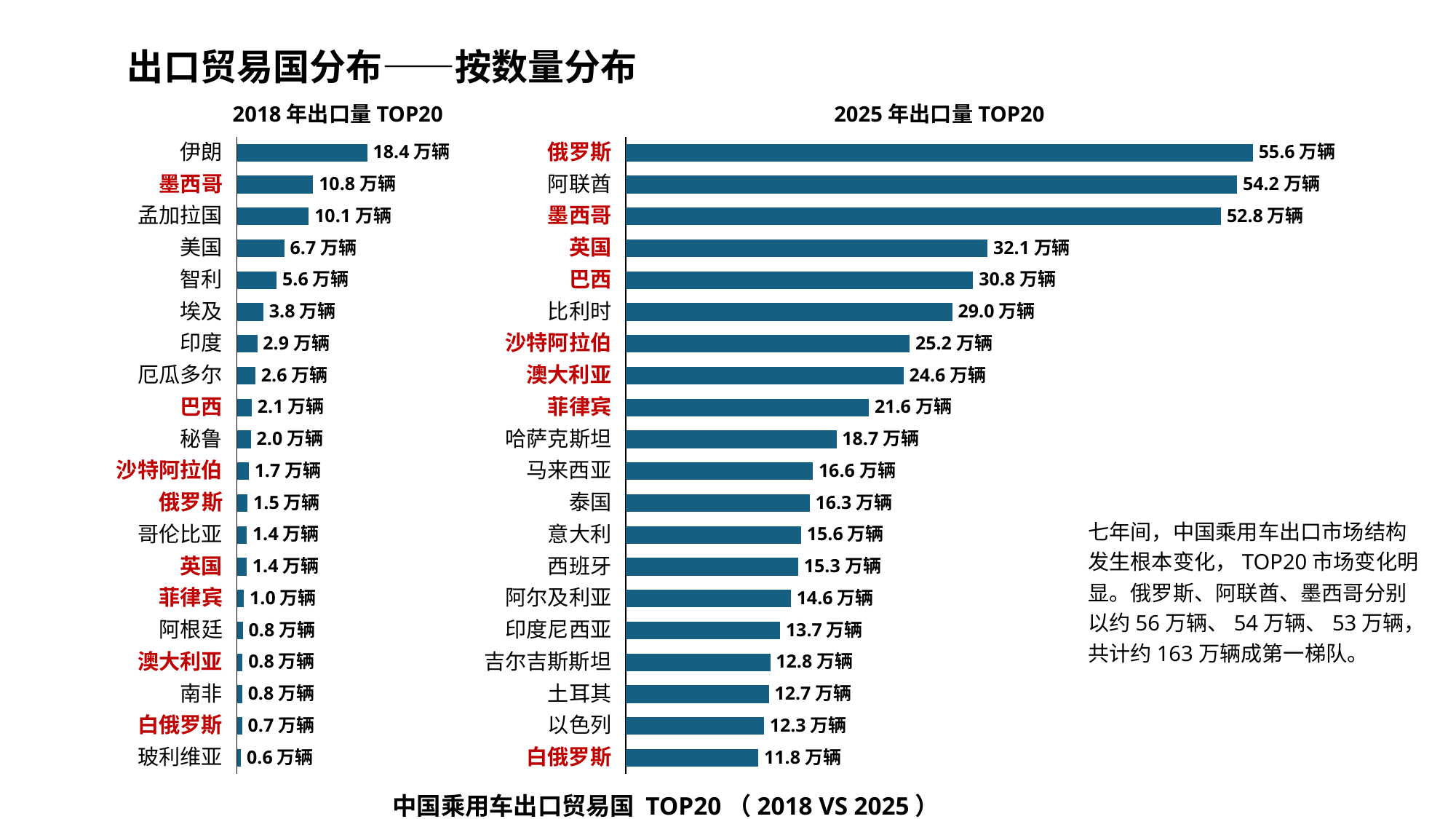
In the 2025 年出口量 TOP20 chart, what is the value for 阿联酋? 54.2 万辆 What kind of chart is the 2018 年出口量 TOP20 chart? Bar chart In the 2025 年出口量 TOP20 chart, what is the difference between 俄罗斯 and 墨西哥? 2.8 万辆 In the 2025 年出口量 TOP20 chart, which is larger, 英国 or 巴西? 英国 In the 2025 年出口量 TOP20 chart, what is the value for 白俄罗斯? 11.8 万辆 In the 2018 年出口量 TOP20 chart, which country has the lowest value? 玻利维亚 In the 2018 年出口量 TOP20 chart, which is larger, 美国 or 智利? 美国 In the 2018 年出口量 TOP20 chart, what is the value for 伊朗? 18.4 万辆 In the 2018 年出口量 TOP20 chart, what is the difference between 墨西哥 and 孟加拉国? 0.7 万辆 How many countries are shown in the 2025 年出口量 TOP20 chart? 20 What is the caption shown below the two charts? 中国乘用车出口贸易国 TOP20 （2018 VS 2025） In the 2025 年出口量 TOP20 chart, which country has the highest value? 俄罗斯